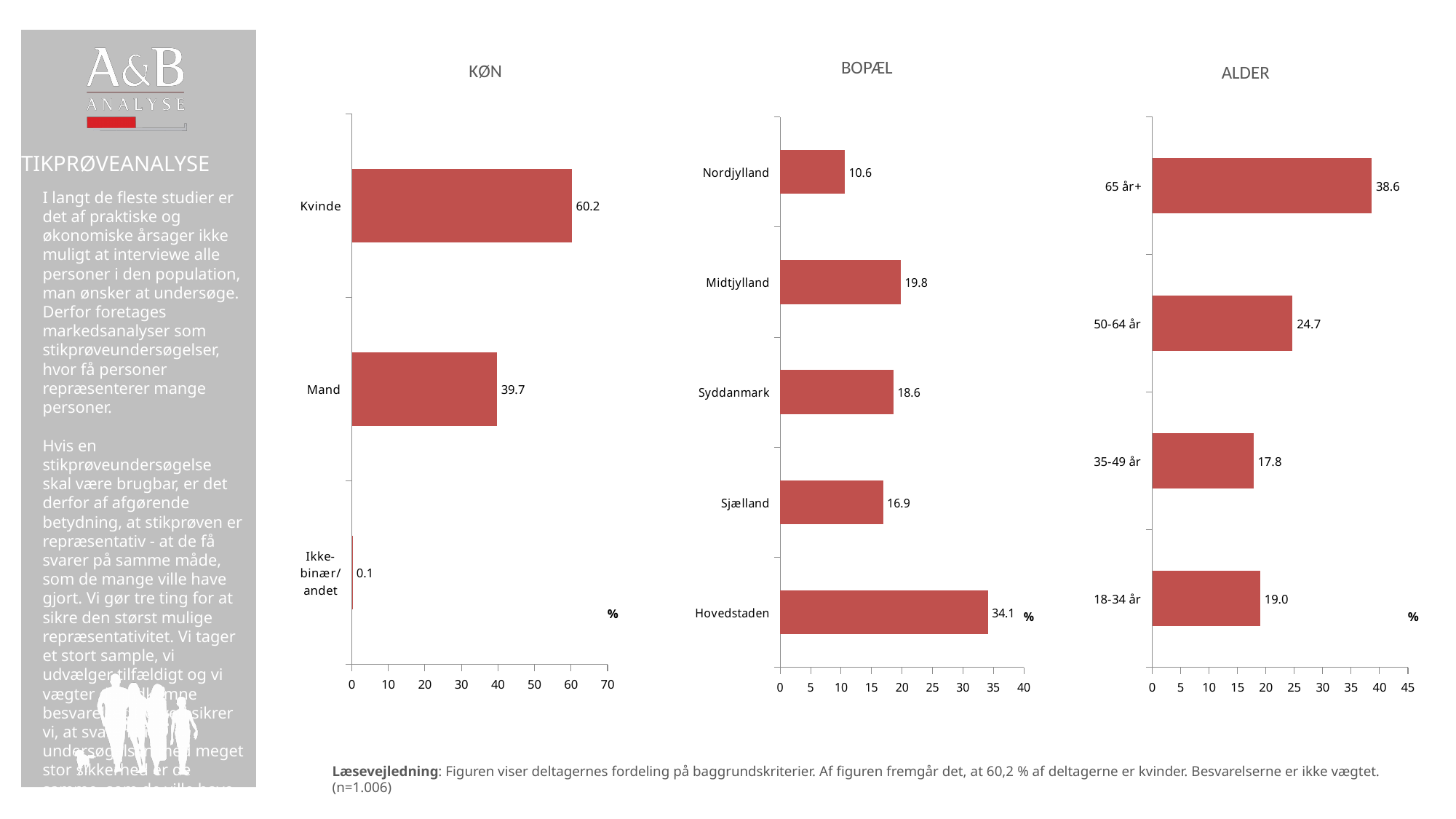
In the BOPÆL chart, what is the value for Midtjylland? 19.8 In the ALDER chart, what is the value for 50-64 år? 24.7 In the KØN chart, which category has the lowest value? Ikke-binær/andet In the BOPÆL chart, how many regions are shown? 5 In the KØN chart, what is the difference between the values for Kvinde and Mand? 20.5 In the BOPÆL chart, which region has the lowest value? Nordjylland In the ALDER chart, which is larger, the value for 18-34 år or 35-49 år? 18-34 år In the BOPÆL chart, which region has the highest value? Hovedstaden In the ALDER chart, which age group has the highest value? 65 år+ In the KØN chart, what is the value for Mand? 39.7 What kind of chart is the ALDER chart? Bar chart In the KØN chart, what is the value for Kvinde? 60.2